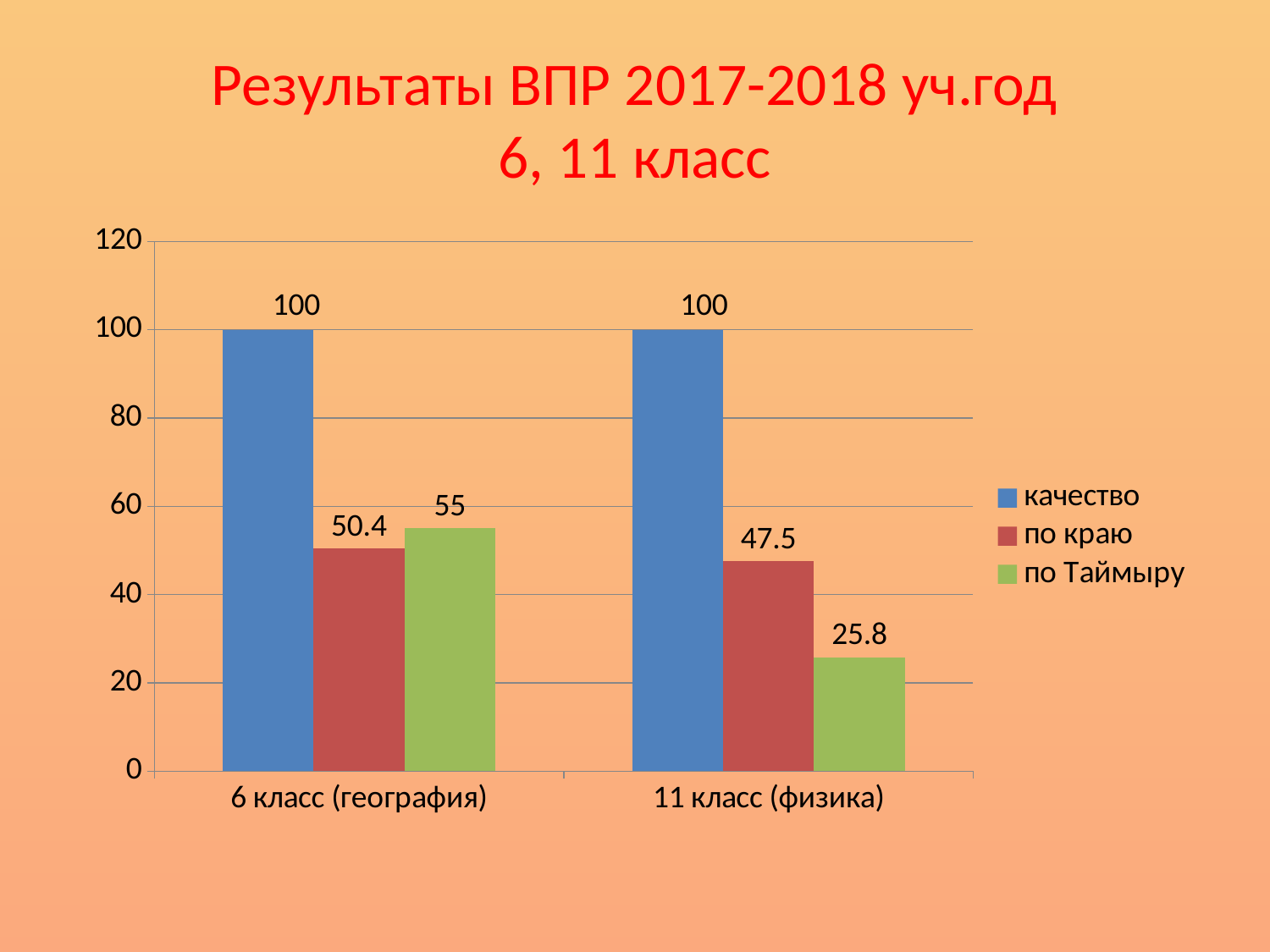
What is the difference between the "по краю" values for "6 класс (география)" and "11 класс (физика)"? 2.9 Which series has the lowest value in the "11 класс (физика)" category? по Таймыру How many categories are shown on the x axis? 2 Which series has the highest value in the "6 класс (география)" category? качество What is the value for "по Таймыру" in the "11 класс (физика)" category? 25.8 What is the value for "качество" in the "6 класс (география)" category? 100 What is the value for "по Таймыру" in the "6 класс (география)" category? 55 What is the value for "по краю" in the "11 класс (физика)" category? 47.5 What kind of chart is shown on the slide? bar chart Which is larger: "по Таймыру" for "6 класс (география)" or "по Таймыру" for "11 класс (физика)"? 6 класс (география) What is the difference between "по Таймыру" and "по краю" in the "6 класс (география)" category? 4.6 How many series does the legend list? 3